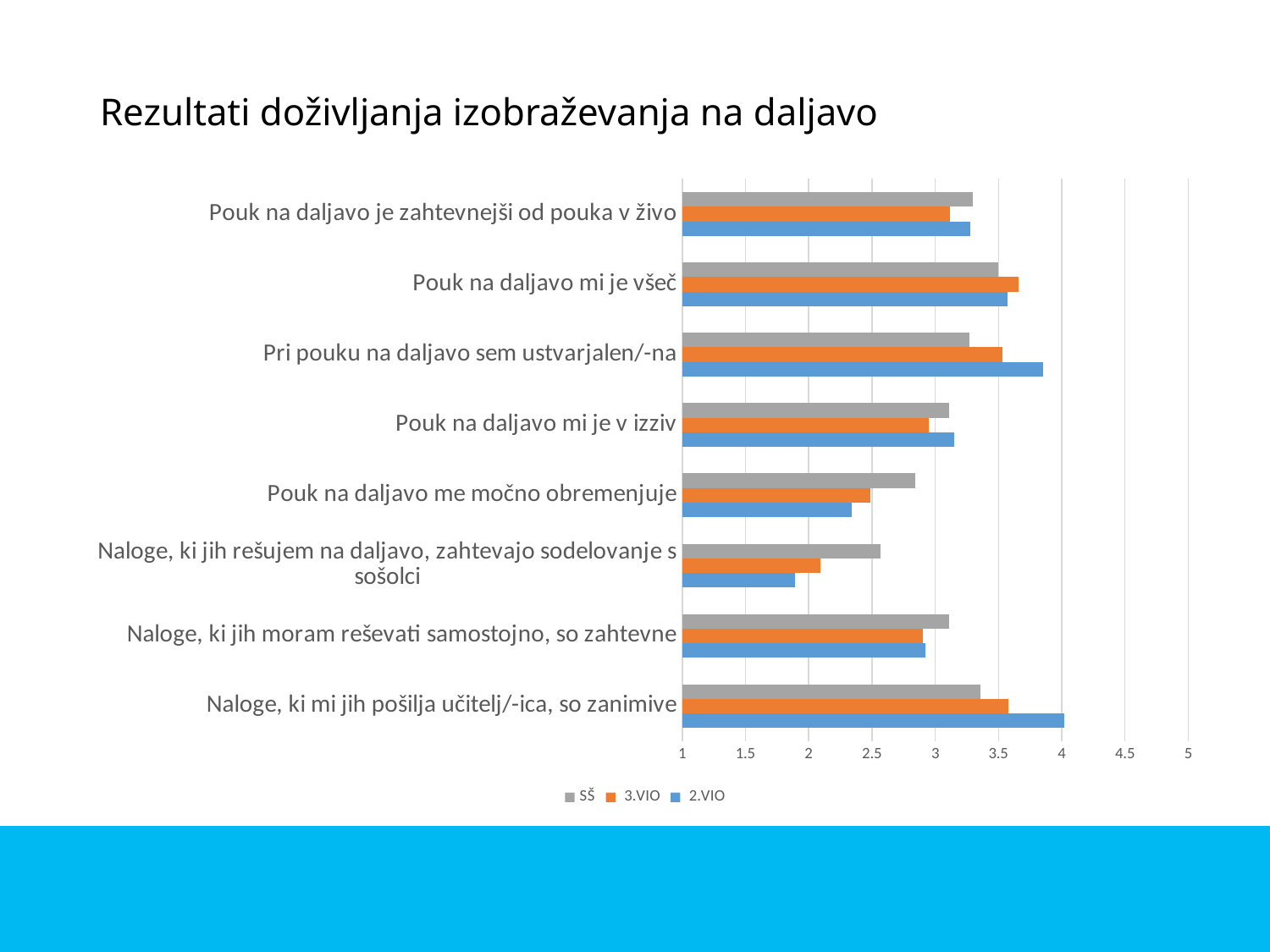
What kind of chart is shown on the slide? Bar chart Which series are listed in the chart legend? SŠ, 3.VIO, 2.VIO What is the title of the slide containing the chart? Rezultati doživljanja izobraževanja na daljavo Is the SŠ value for "Pouk na daljavo me močno obremenjuje" greater or less than 3? less For which statement is the 2.VIO value the lowest? Naloge, ki jih rešujem na daljavo, zahtevajo sodelovanje s sošolci Is the 3.VIO value for "Naloge, ki jih rešujem na daljavo, zahtevajo sodelovanje s sošolci" greater or less than 2.5? less For which statement is the 2.VIO value the highest? Naloge, ki mi jih pošilja učitelj/-ica, so zanimive Is the 2.VIO value for "Naloge, ki mi jih pošilja učitelj/-ica, so zanimive" greater or less than 3.5? greater For "Pri pouku na daljavo sem ustvarjalen/-na", which is larger: the 2.VIO value or the SŠ value? 2.VIO How many series does the legend list? 3 How many categories (statements) are plotted on the chart? 8